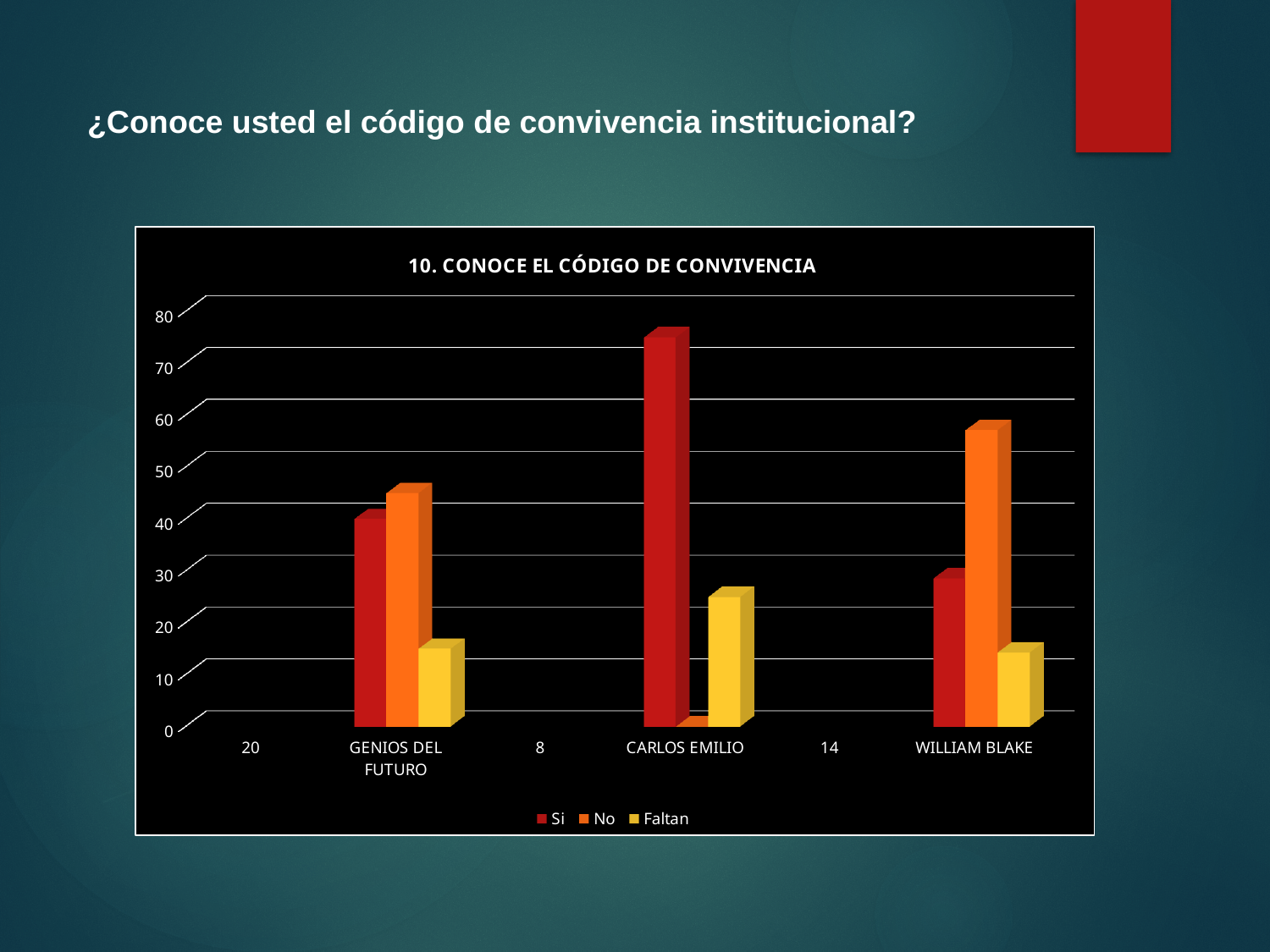
Which is larger, the Faltan value for CARLOS EMILIO or the Faltan value for GENIOS DEL FUTURO? CARLOS EMILIO Is the Si value for CARLOS EMILIO greater or less than 70? greater Is the Si value for GENIOS DEL FUTURO greater or less than 30? greater Which category has the highest value for the Si series? CARLOS EMILIO Is the Faltan value for CARLOS EMILIO greater or less than 30? less How many series does the chart legend list? 3 Which category has the lowest value for the No series? CARLOS EMILIO What kind of chart is shown on the slide? Bar chart What is the title of the chart? 10. CONOCE EL CÓDIGO DE CONVIVENCIA Which category has the highest value for the No series? WILLIAM BLAKE What are the series names listed in the chart legend? Si, No, Faltan